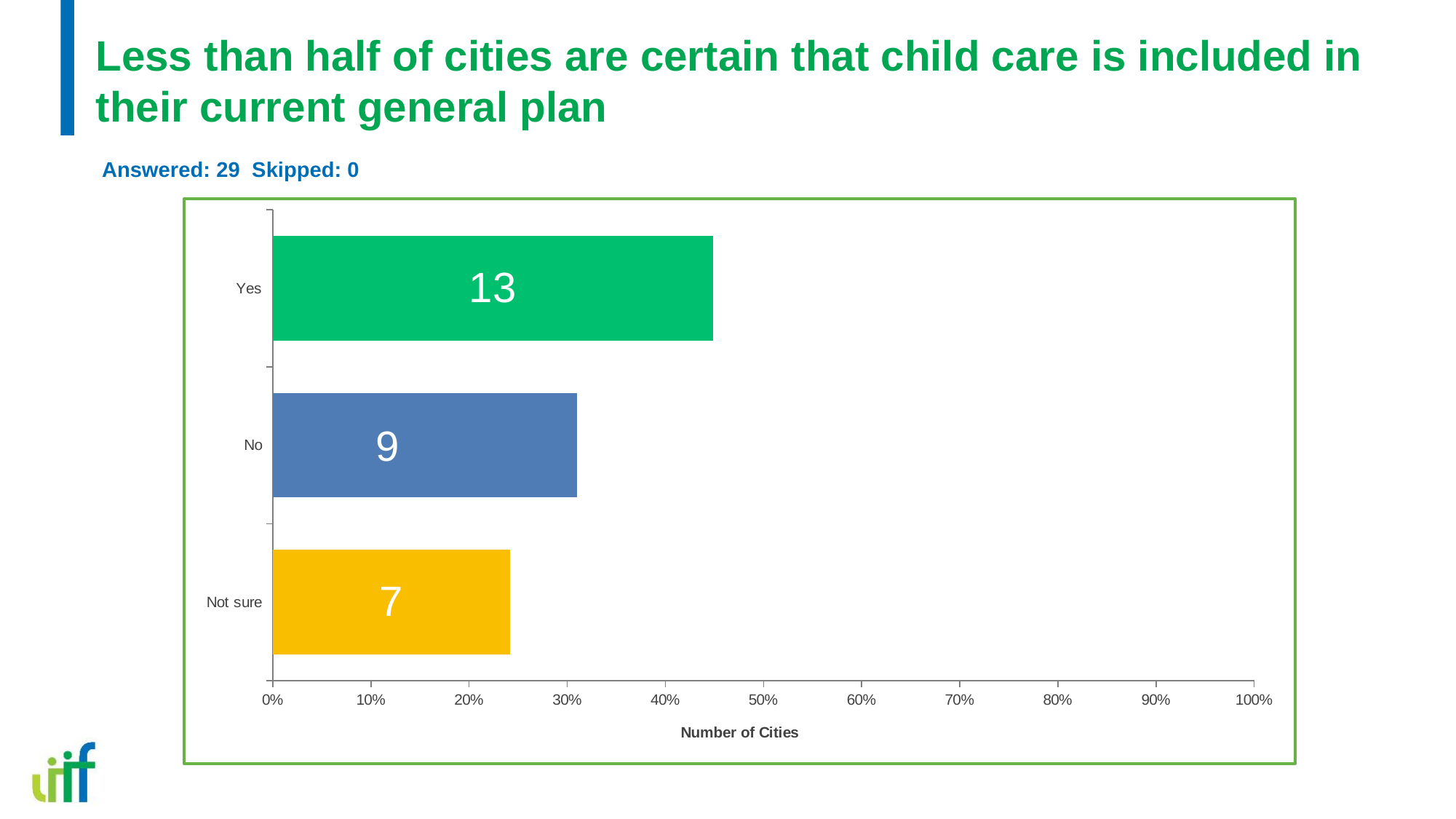
How many response categories are shown in the chart? 3 What is the difference between the number of cities answering "Yes" and the number answering "No"? 4 Which has more cities, "No" or "Not sure"? No How many cities answered "Yes"? 13 How many cities answered "Not sure"? 7 How many cities answered "No"? 9 Which response category has the highest number of cities? Yes What type of chart is shown on the slide? Bar chart What is the difference between the number of cities answering "No" and the number answering "Not sure"? 2 Which response category has the lowest number of cities? Not sure Is the percentage for "Not sure" greater or less than 20%? greater Is the percentage for "Yes" greater or less than 50%? less